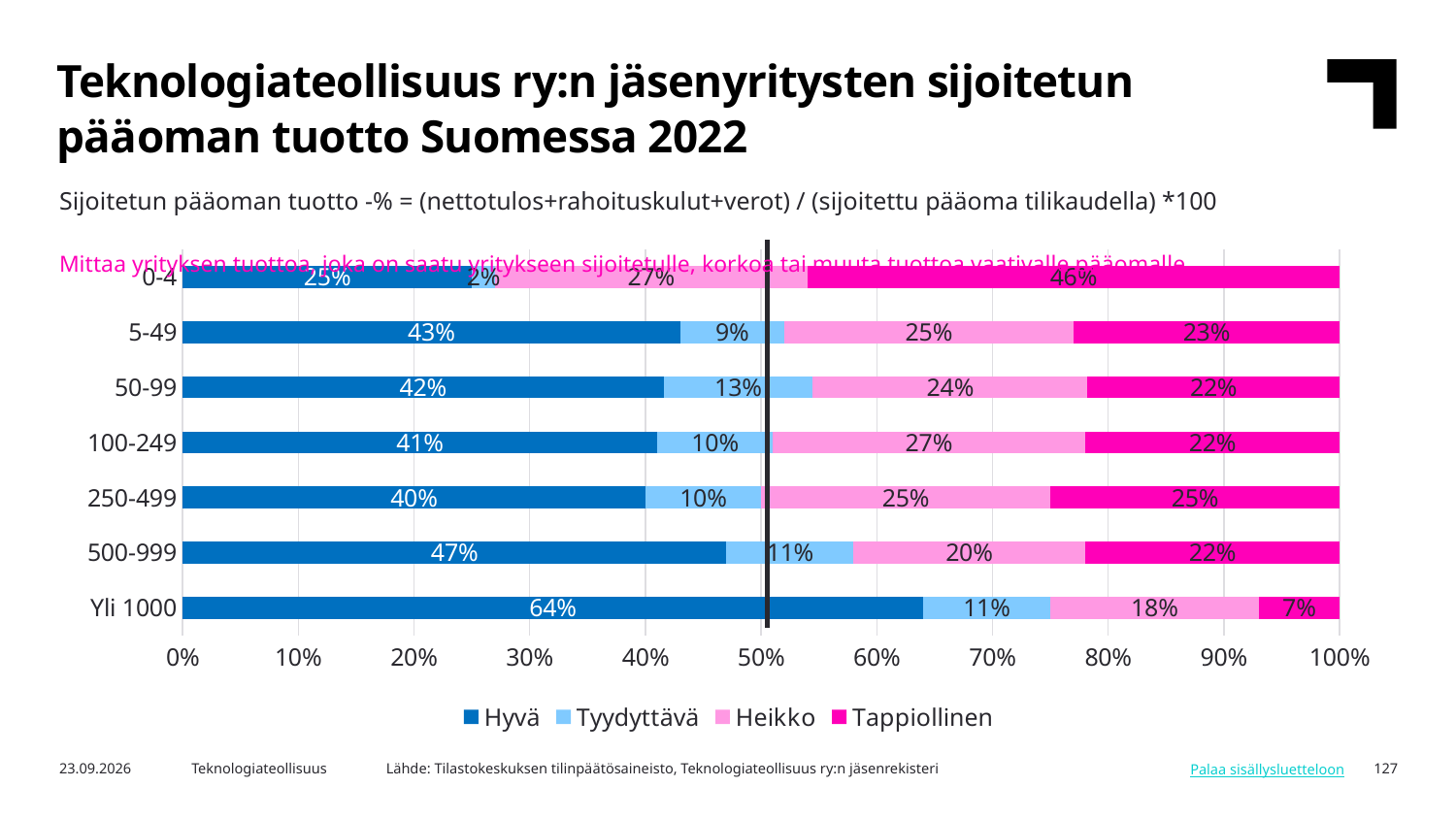
What is the difference between the Hyvä share of Yli 1000 and the Hyvä share of 500-999? 17 percentage points Which is larger: the Heikko share for 100-249 or the Heikko share for 250-499? 100-249 Which size class has the highest Hyvä share? Yli 1000 How many series does the legend list? 4 Which size class has the lowest Tappiollinen share? Yli 1000 What kind of chart is shown on the slide? Stacked bar chart What is the Hyvä share for the Yli 1000 size class? 64% What is the Heikko share for the 500-999 size class? 20% What is the Tyydyttävä share for the 50-99 size class? 13% How many size classes are shown on the chart? 7 Which size class has the highest Tappiollinen share? 0-4 What is the Tappiollinen share for the 5-49 size class? 23%